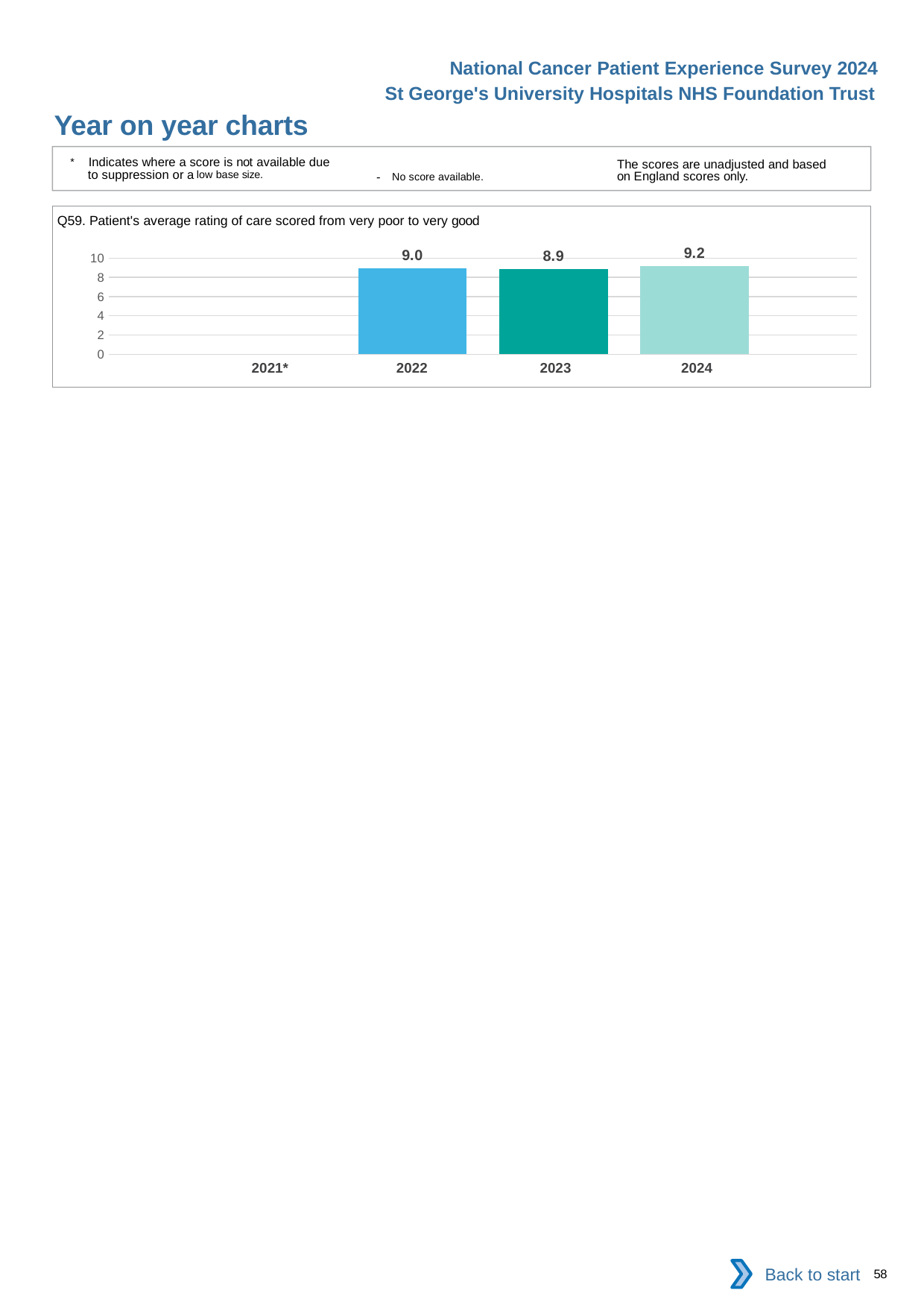
What is the value for 2023 in the Q59 chart? 8.9 What is the difference between the 2024 and 2023 values in the Q59 chart? 0.3 What is the value for 2022 in the Q59 chart? 9.0 What is the difference between the 2022 and 2023 values in the Q59 chart? 0.1 Is the value for 2024 greater or less than 8 in the Q59 chart? greater What kind of chart is used for Q59? Bar chart How many year categories are shown on the x axis of the Q59 chart? 4 What is the title of the chart on the slide? Q59. Patient's average rating of care scored from very poor to very good What is the value for 2024 in the Q59 chart? 9.2 Which year in the Q59 chart has no bar plotted? 2021* Which year has the highest value in the Q59 chart? 2024 Among the years with a plotted value, which year has the lowest value in the Q59 chart? 2023